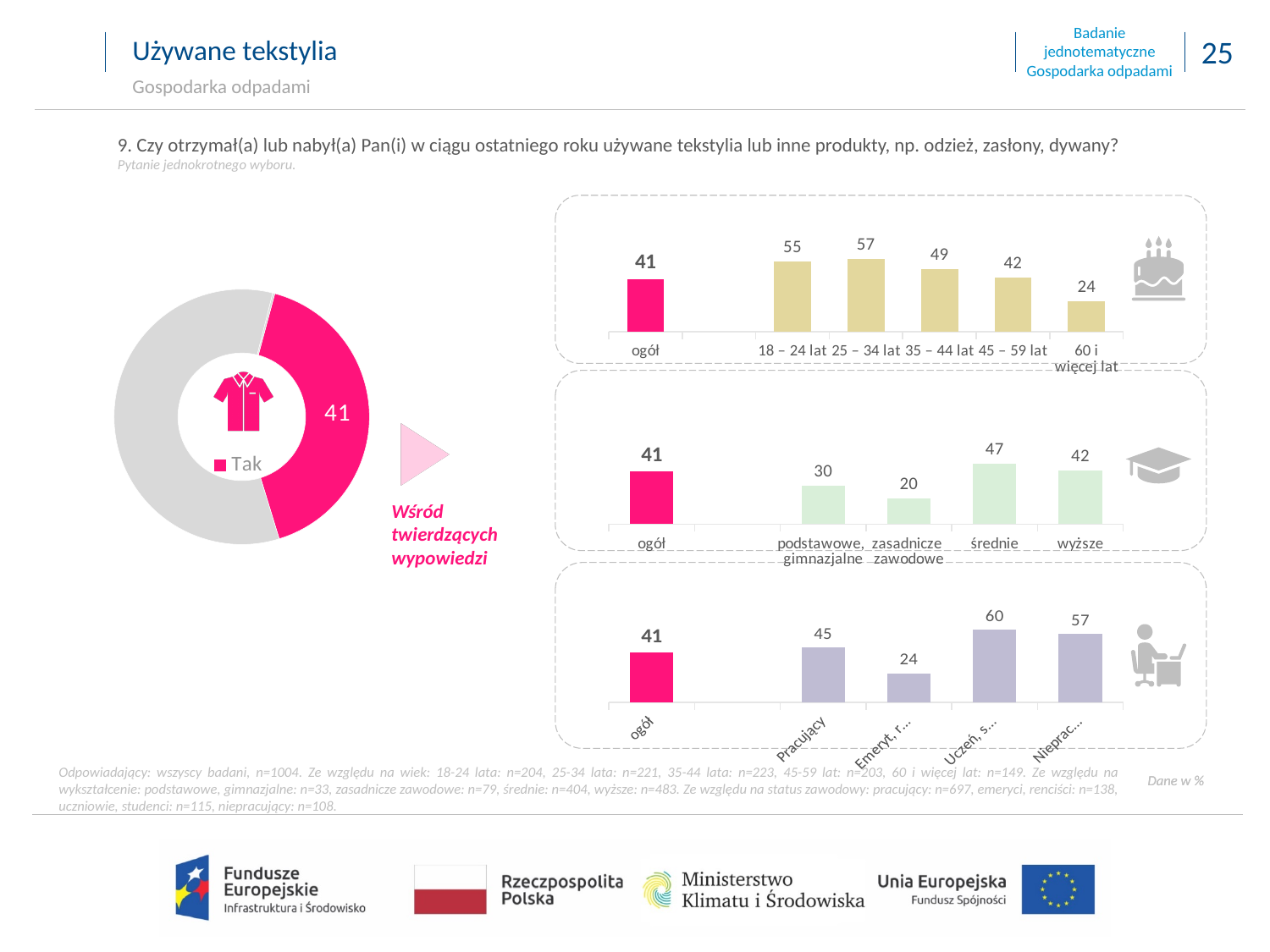
In the top bar chart by age, how many age groups are shown (excluding ogół)? 5 In the top bar chart by age, what is the difference between the values for 18 – 24 lat and 60 i więcej lat? 31 In the top bar chart by age, which age group has the highest value? 25 – 34 lat What kind of chart is the chart on the left showing the "Tak" share? Pie (donut) chart In the middle bar chart by education, what is the value for zasadnicze zawodowe? 20 In the top bar chart by age, what is the value for 25 – 34 lat? 57 In the bottom bar chart by occupational status, what is the highest value shown among the occupational groups? 60 In the top bar chart by age, which age group has the lowest value? 60 i więcej lat In the donut chart on the left, what percentage of respondents answered "Tak"? 41 In the middle bar chart by education, is the value for średnie larger or smaller than the value for wyższe? larger In the middle bar chart by education, which education level has the highest value? średnie In the bottom bar chart by occupational status, what is the value for Pracujący? 45